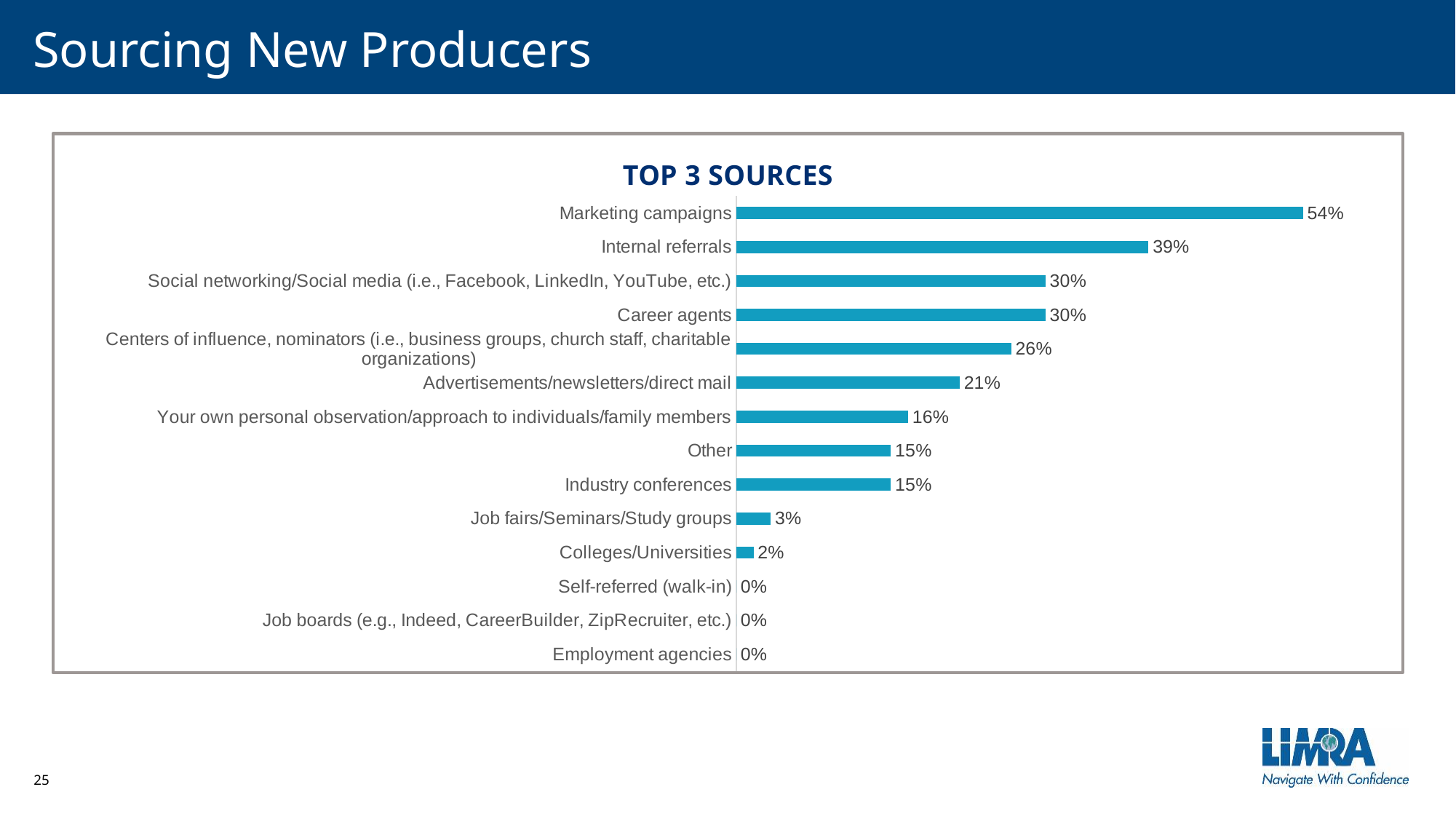
Which category has the highest value? Marketing campaigns How many categories have a value of 0%? 3 What is the value for Internal referrals? 39% What kind of chart is shown? Bar chart What is the value for Advertisements/newsletters/direct mail? 21% How many categories are shown in the chart? 14 Which is larger, Centers of influence, nominators or Your own personal observation/approach to individuals/family members? Centers of influence, nominators What is the difference between Marketing campaigns and Internal referrals? 15% What is the value for Job fairs/Seminars/Study groups? 3% What is the value for Marketing campaigns? 54% What is the difference between Career agents and Advertisements/newsletters/direct mail? 9% What is the title of the chart? TOP 3 SOURCES